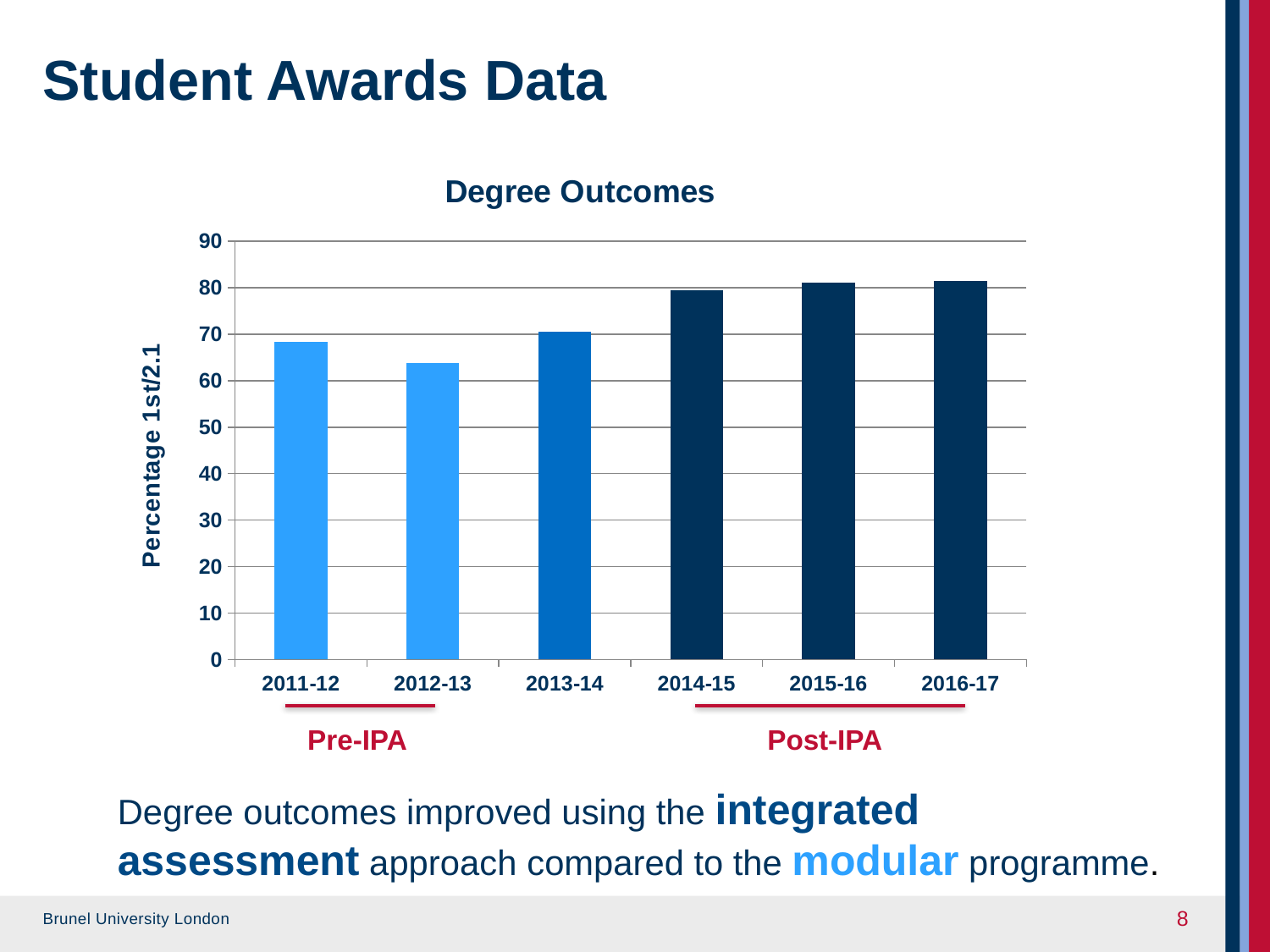
Is the value for 2016-17 greater or less than 90? less Is the value for 2012-13 greater or less than 70? less What type of chart is shown on the slide? bar chart What is the title of the chart? Degree Outcomes Do the values rise or fall from 2012-13 to 2016-17? rise Is the value for 2014-15 greater or less than 70? greater What is the label on the vertical axis of the chart? Percentage 1st/2.1 How many academic years are shown on the x axis of the chart? 6 Which is larger, the value for 2013-14 or the value for 2015-16? 2015-16 Which is larger, the value for 2011-12 or the value for 2012-13? 2011-12 Which academic year has the lowest percentage of 1st/2.1 degrees? 2012-13